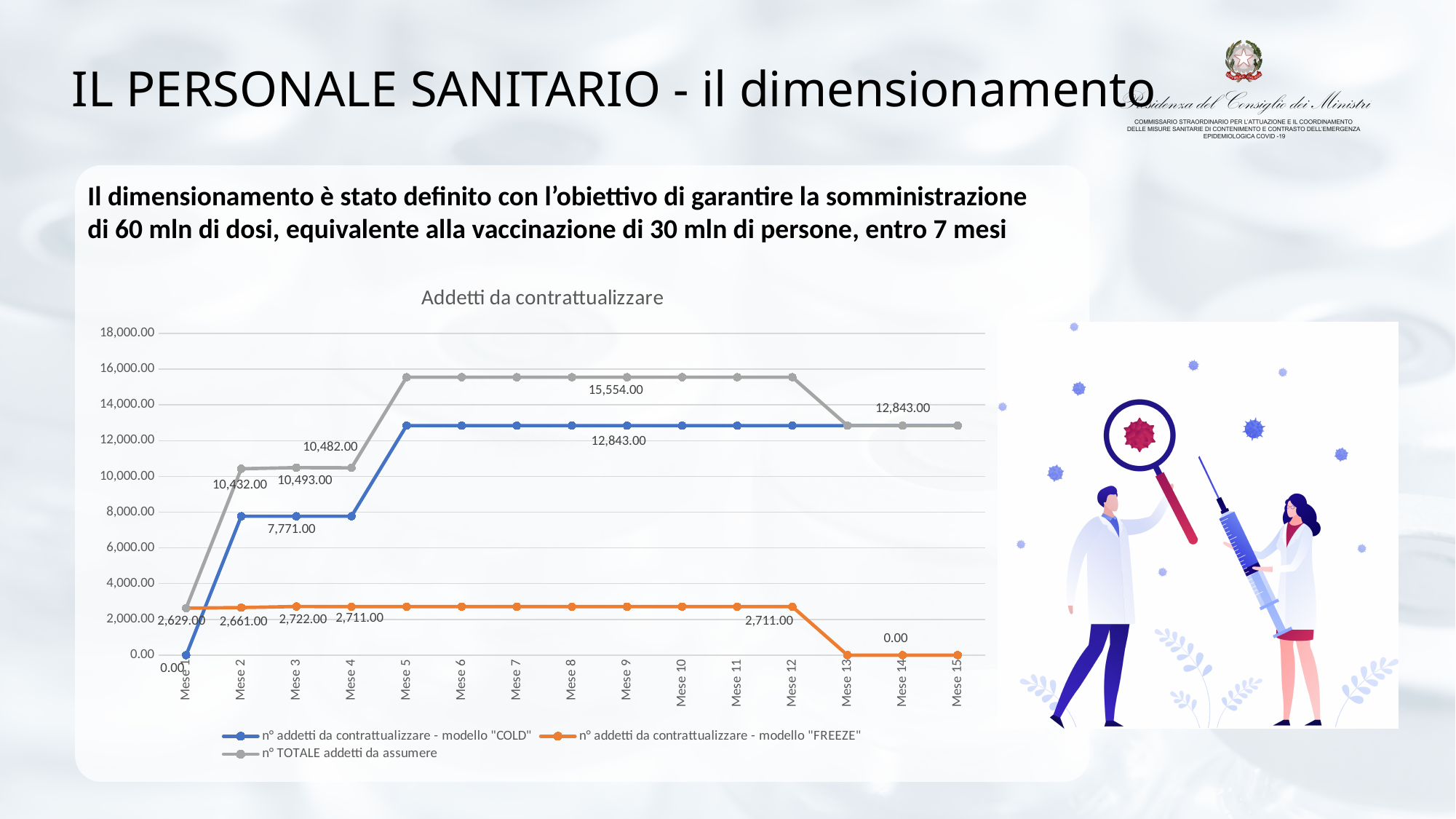
What kind of chart is shown on the slide? line chart What is the title of the chart? Addetti da contrattualizzare How many series does the chart legend list? 3 What is the value of the 'modello COLD' series at Mese 2? 7,771.00 What is the value of the 'n° TOTALE addetti da assumere' series at Mese 8? 15,554.00 How many months (Mese) are plotted along the x axis? 15 What is the difference between the TOTALE value and the COLD value at Mese 2? 2,661.00 Does the 'modello FREEZE' series rise or fall between Mese 12 and Mese 13? fall What is the value of the 'n° TOTALE addetti da assumere' series at Mese 2? 10,432.00 What is the value of the 'modello FREEZE' series at Mese 14? 0.00 Which series has the highest value at Mese 8? n° TOTALE addetti da assumere What is the value of the 'modello FREEZE' series at Mese 1? 2,629.00